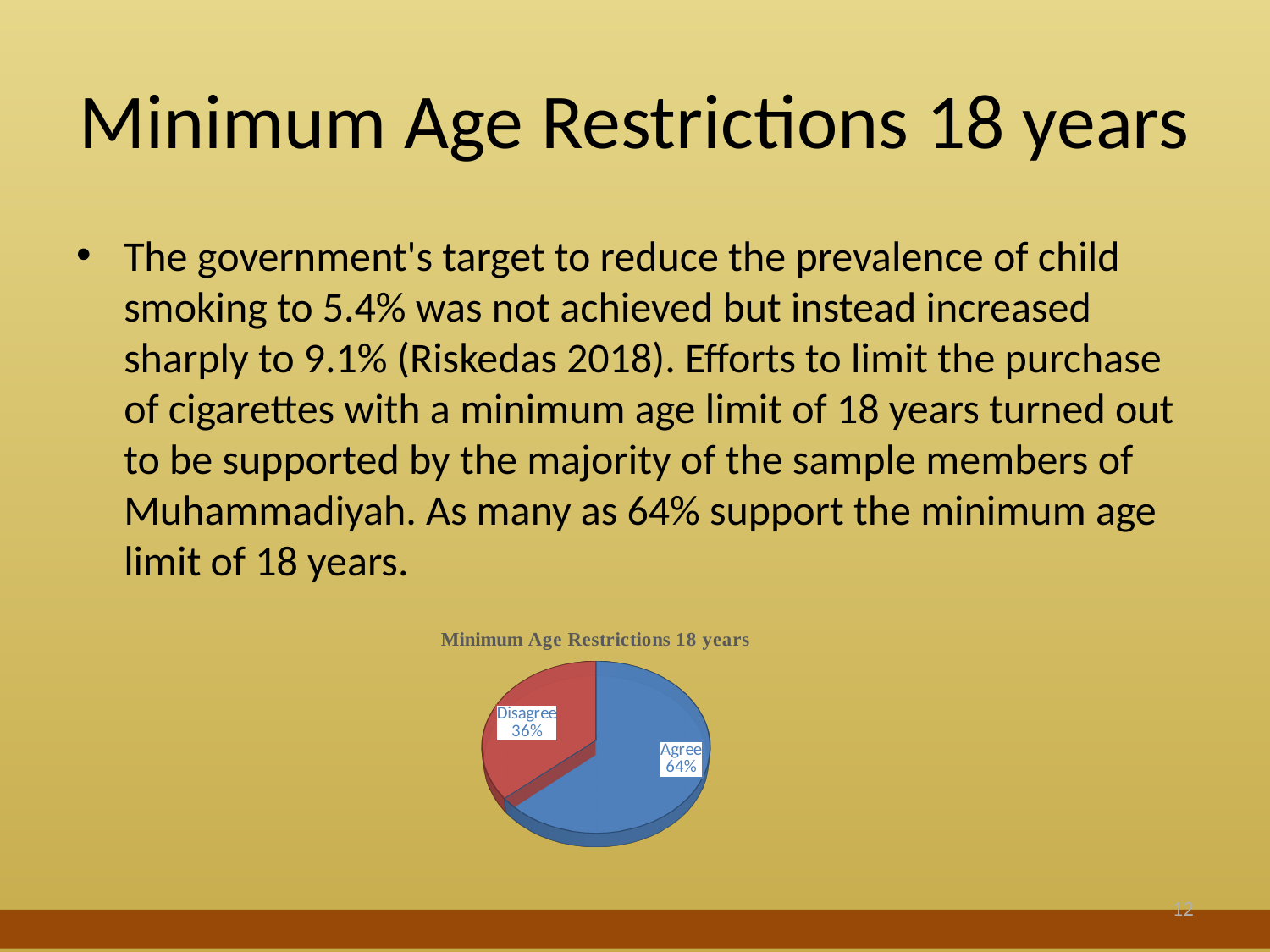
Which is larger, the Agree slice or the Disagree slice? Agree What is the title of the chart? Minimum Age Restrictions 18 years How many slices does the pie chart have? 2 What is the difference in percentage points between the Agree and Disagree slices? 28% What share of the pie is labelled Disagree? 36% What colour is the Agree slice of the pie? blue Which slice of the pie is the smallest? Disagree What share of the pie is labelled Agree? 64% Which slice of the pie is the largest? Agree What kind of chart is shown on the slide? pie chart